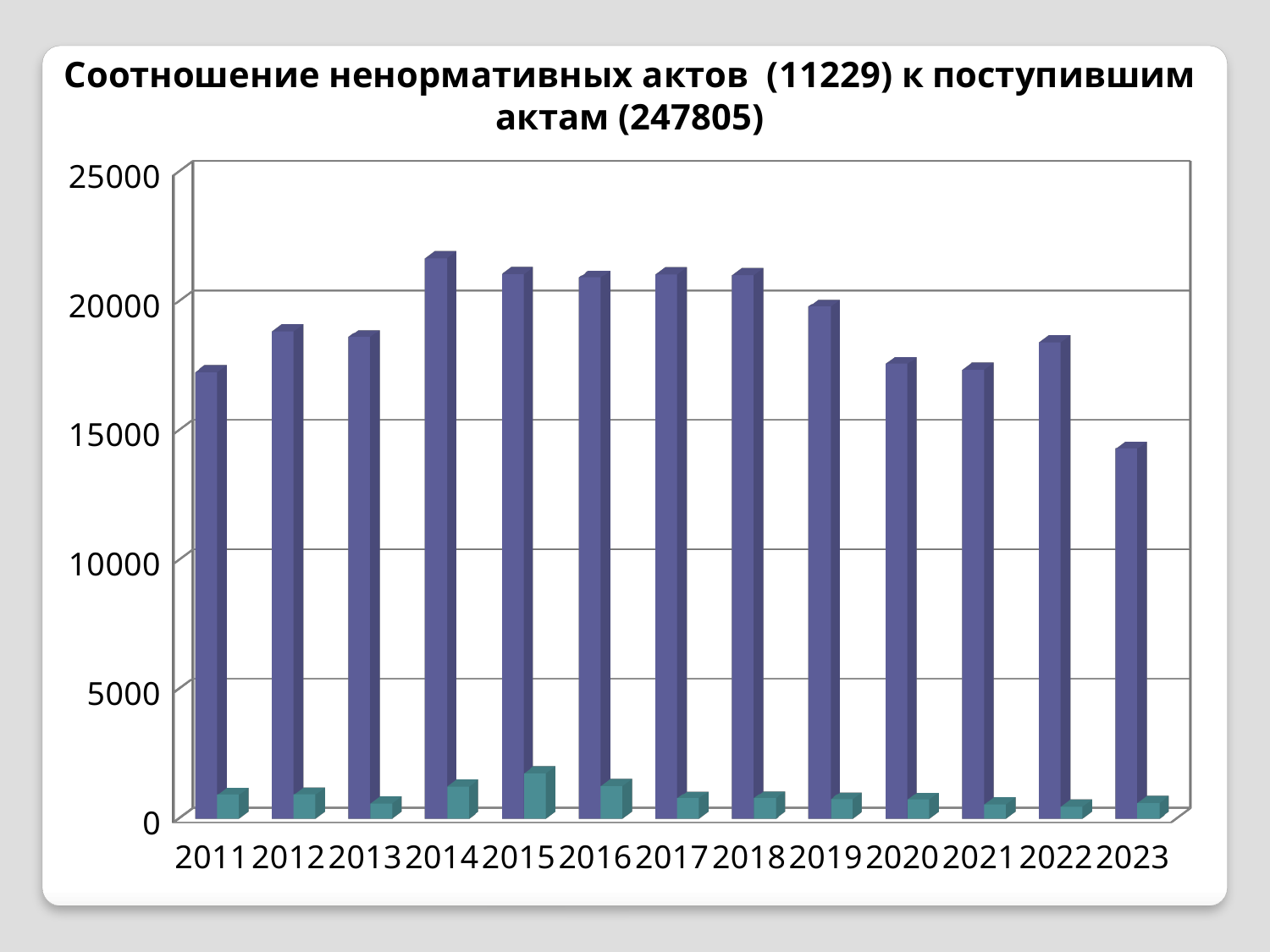
Is the teal bar for 2015 greater or less than 5000? less What total number of received acts (поступившим актам) is given in the chart title? 247805 Is the purple bar for 2014 greater or less than 20000? greater How many years are shown along the x axis? 13 Is the purple bar for 2020 greater or less than 20000? less Which year has the tallest purple bar? 2014 What kind of chart is shown on the slide? Bar chart Which year has the shortest purple bar? 2023 Which purple bar is taller, 2011 or 2012? 2012 Do the purple bars rise or fall from 2018 to 2021? fall Which year has the tallest teal bar? 2015